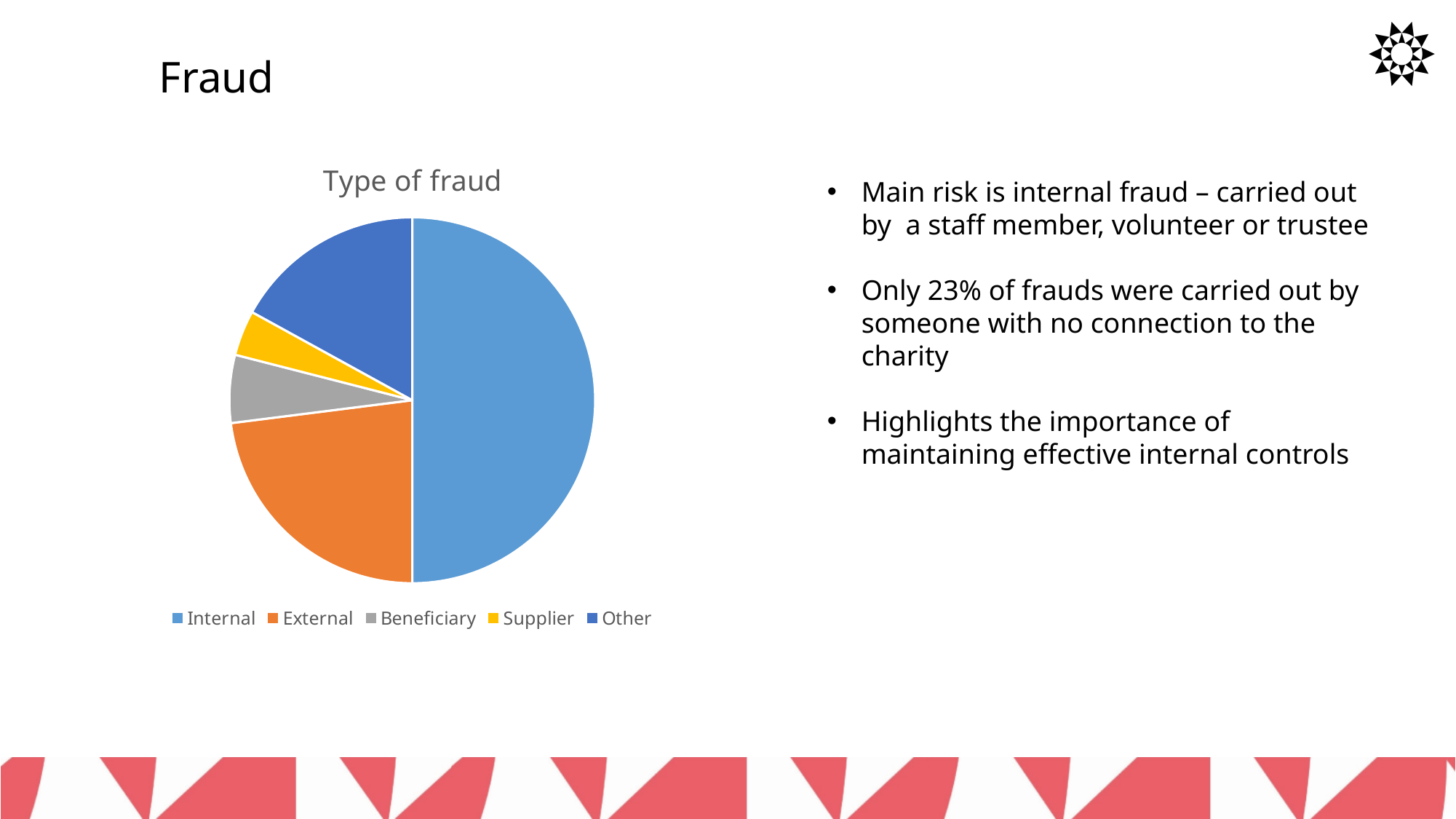
Which slice is larger, Other or Beneficiary? Other Which slice is larger, External or Other? External What colour is the Supplier slice in the pie chart? Yellow Which slice is larger, Internal or Other? Internal How many categories does the pie chart show? 5 What kind of chart is shown on the slide? Pie chart How many entries does the chart legend list? 5 Which type of fraud has the largest slice of the pie? Internal What is the title of the chart? Type of fraud